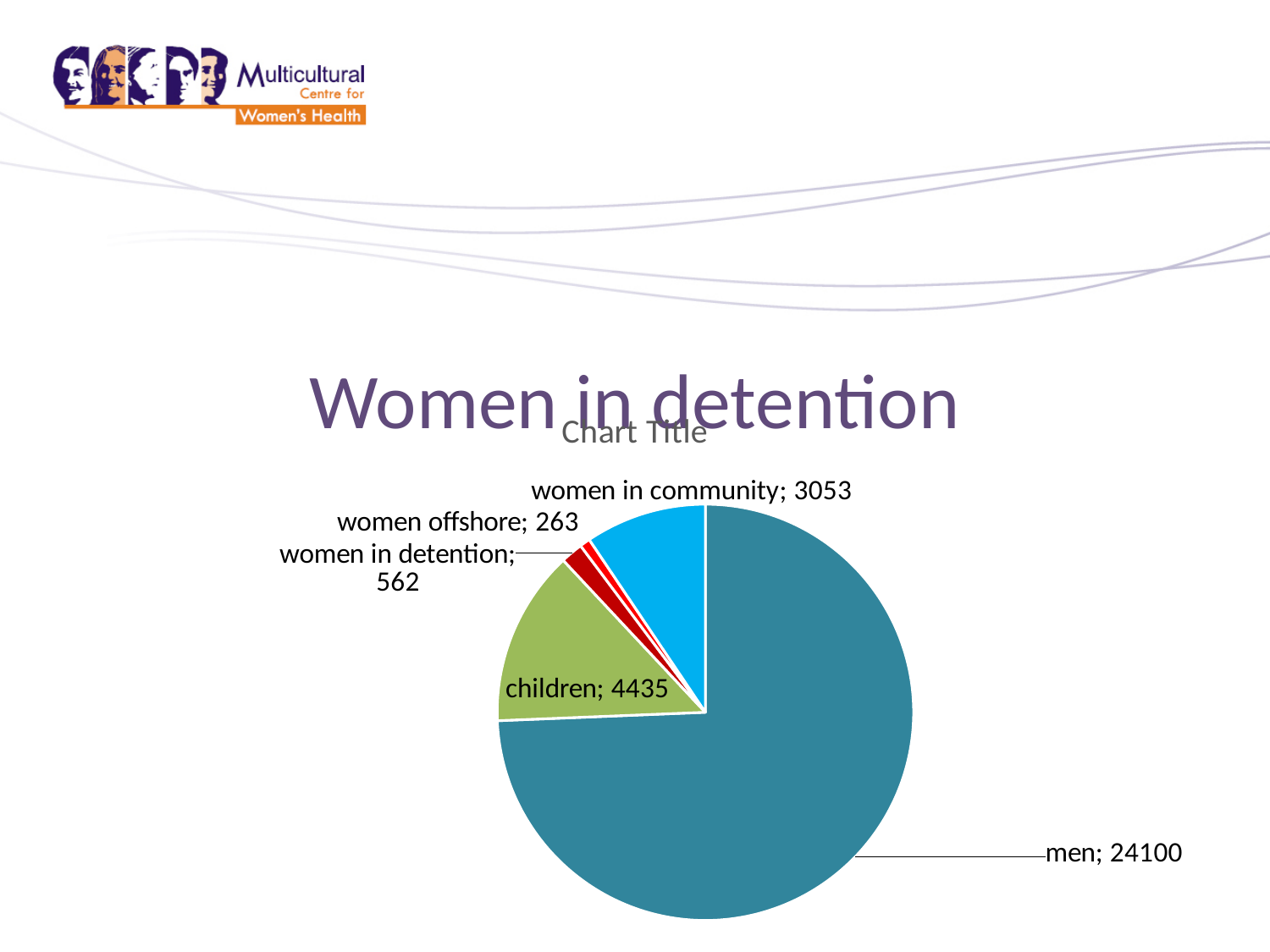
What value is shown for men in the pie chart? 24100 What is the difference between the values for men and children? 19665 How many categories are shown in the pie chart? 5 Which category has the largest slice of the pie chart? men What is the title of the slide containing the chart? Women in detention What kind of chart is shown on the slide? pie chart Which category has the smallest slice of the pie chart? women offshore What value is shown for children in the pie chart? 4435 Which is larger, the value for women in detention or the value for women in community? women in community What value is shown for women in community in the pie chart? 3053 What value is shown for women in detention in the pie chart? 562 What value is shown for women offshore in the pie chart? 263